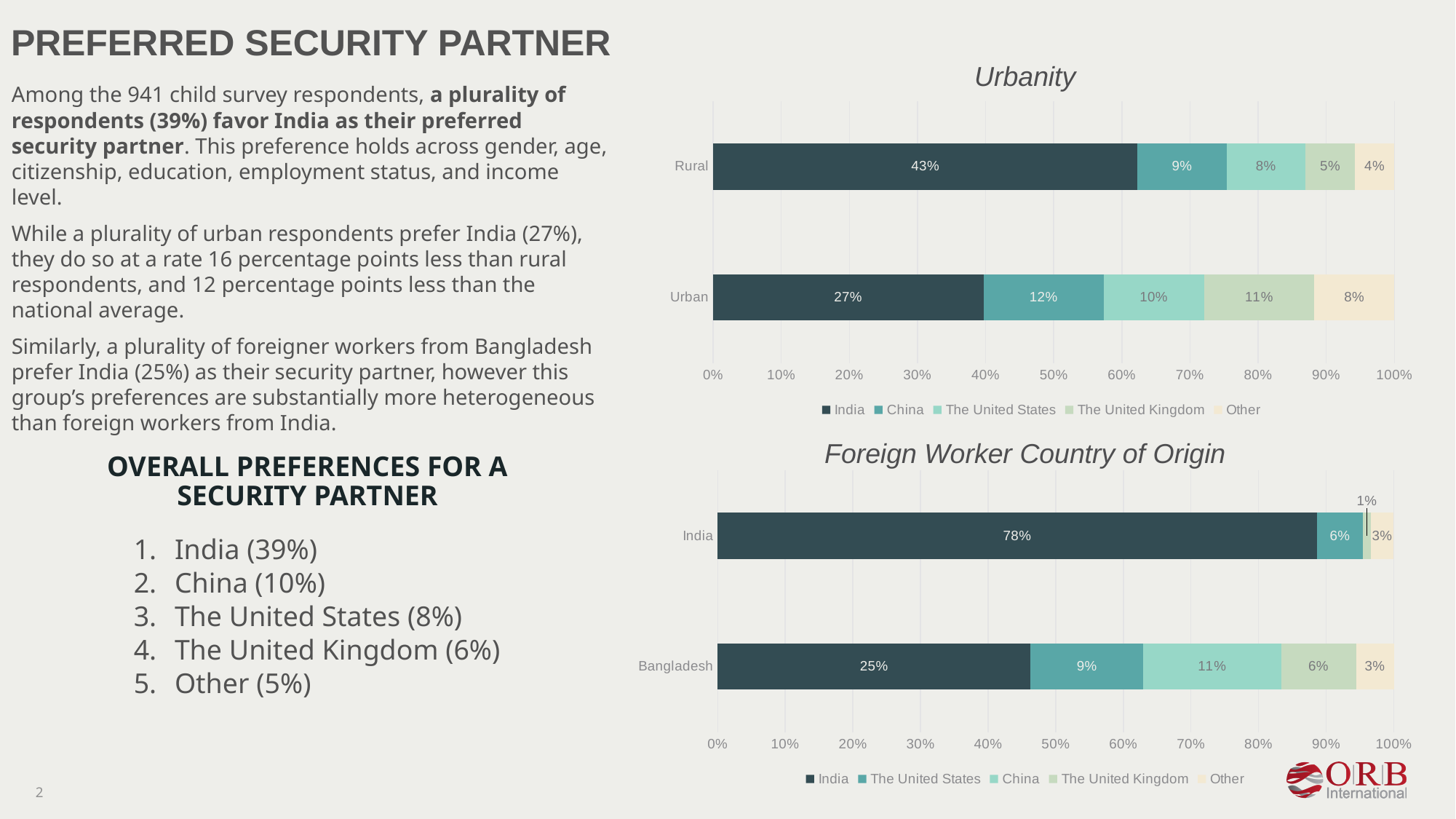
In the Urbanity chart, how many percentage points higher is the India share for Rural than for Urban? 16 percentage points In the Foreign Worker Country of Origin chart, what is the difference between the India share for workers from India and for workers from Bangladesh? 53 percentage points In the Urbanity chart, which group has the larger share preferring India, Rural or Urban? Rural In the Foreign Worker Country of Origin chart, what percentage of foreign workers from India prefer India? 78% What kind of chart is the Urbanity chart? Stacked bar chart In the Foreign Worker Country of Origin chart, how many categories (countries of origin) are shown? 2 In the Foreign Worker Country of Origin chart, what is the value for The United States among workers from Bangladesh? 9% In the Urbanity chart, what is the value for China among urban respondents? 12% In the Urbanity chart, what is the value for Other among rural respondents? 4% In the Urbanity chart, how many series does the legend list? 5 In the Urbanity chart, what percentage of rural respondents prefer India as their security partner? 43% In the Foreign Worker Country of Origin chart, what is the value for China among workers from Bangladesh? 11%